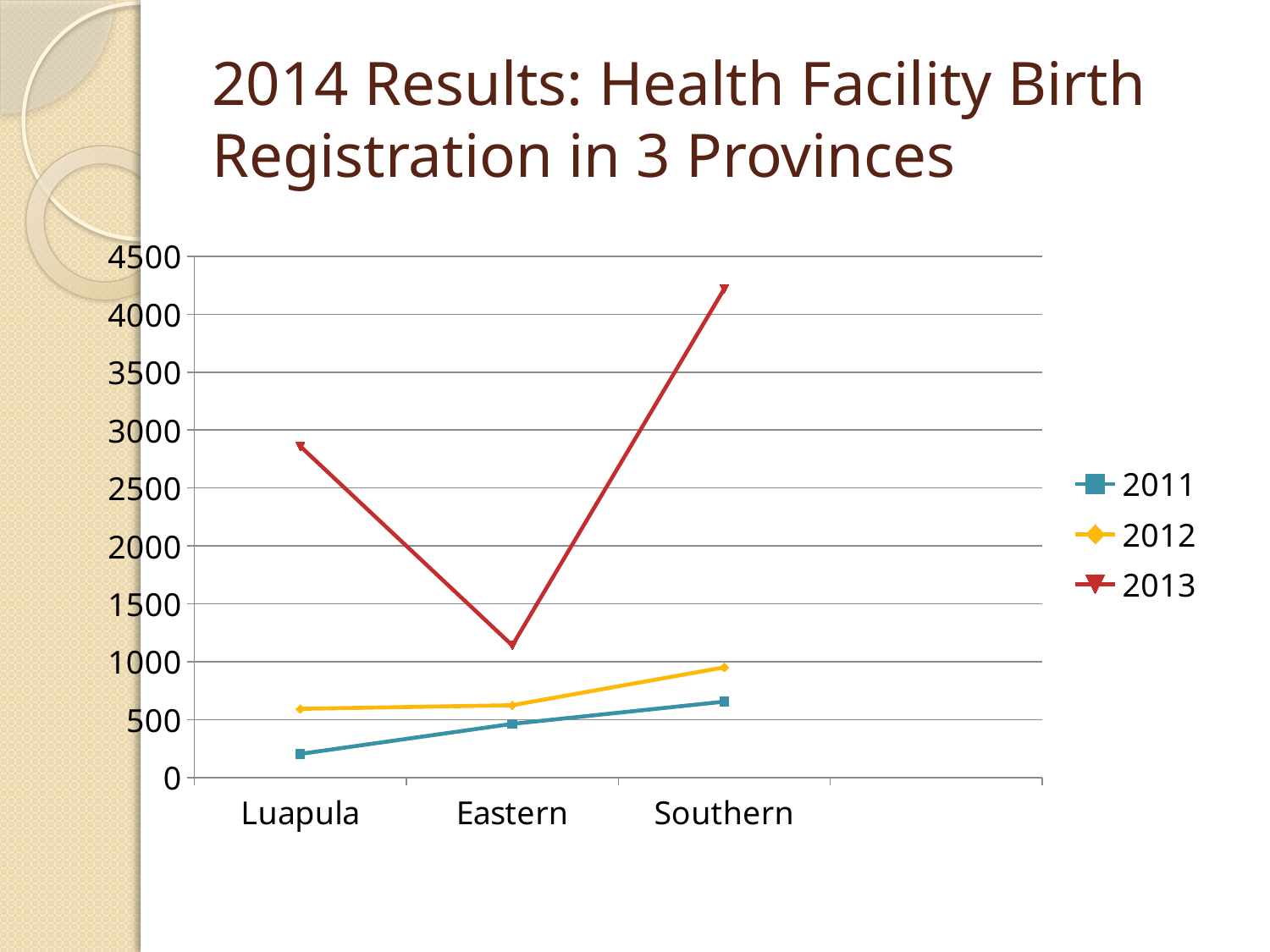
Which province has the lowest value for the 2013 series? Eastern Is the 2013 value for Southern greater or less than 4000? greater For the 2013 series, which is larger: the value for Luapula or the value for Eastern? Luapula Is the 2013 value for Eastern greater or less than 1500? less Which province has the highest value for the 2012 series? Southern Which province has the lowest value for the 2011 series? Luapula Which province has the highest value for the 2013 series? Southern What kind of chart is shown on the slide? line chart What are the three entries listed in the legend? 2011, 2012, 2013 Does the 2011 series rise or fall from Luapula to Southern along the x axis? rises How many series does the legend list? 3 How many provinces are shown on the x axis? 3